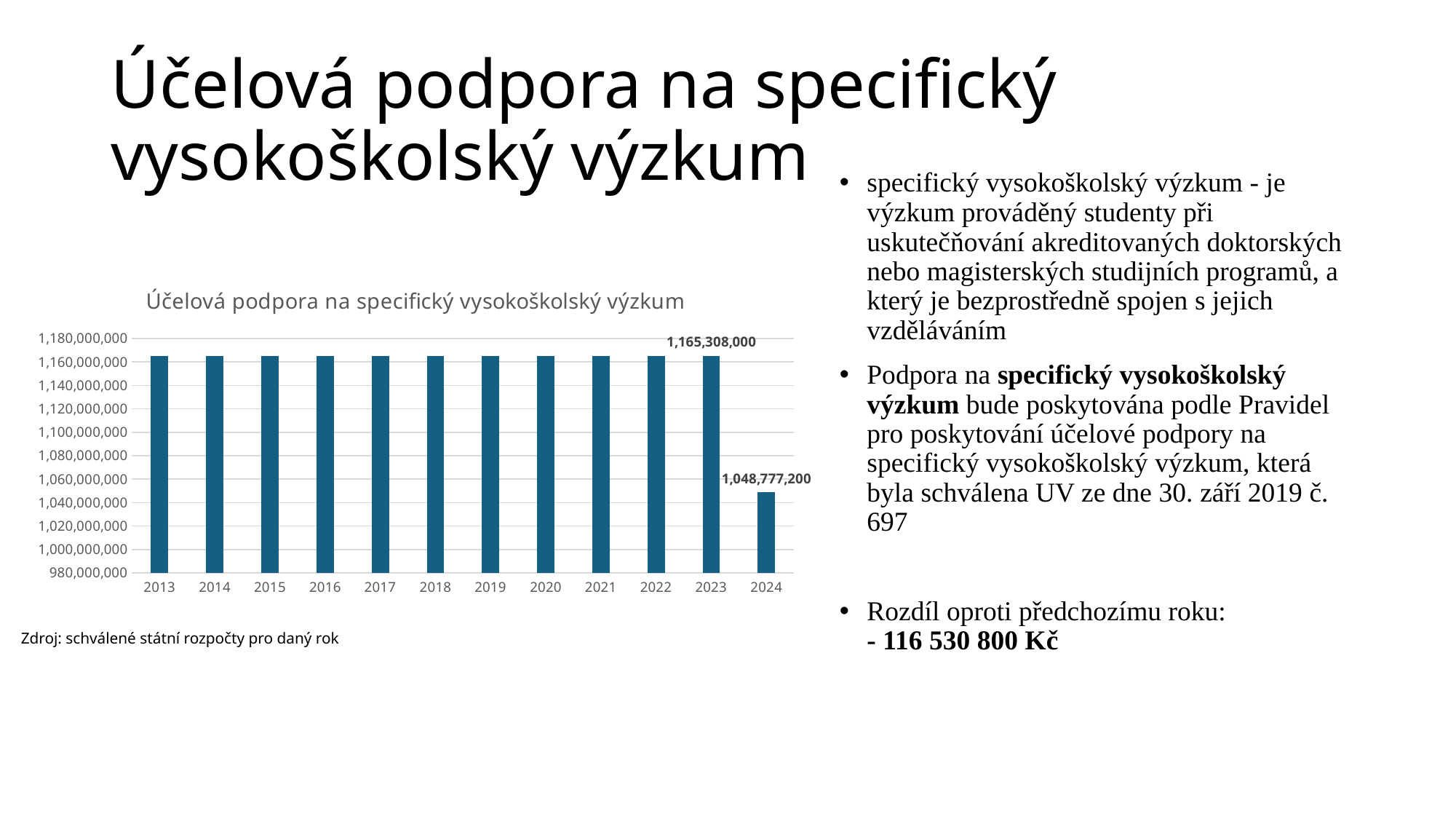
Which year has the lowest value? 2024 What is the title of the chart? Účelová podpora na specifický vysokoškolský výzkum What is the value for 2024? 1,048,777,200 What is the value for 2023? 1,165,308,000 What is the difference between the values for 2023 and 2024? 116,530,800 What is the first year shown on the x axis? 2013 Is the value for 2024 greater or less than 1,060,000,000? less What type of chart is shown on the slide? bar chart How many years are shown on the x axis? 12 Is the value for 2013 greater or less than 1,100,000,000? greater Does the value rise or fall from 2023 to 2024? fall Which is larger, the value for 2023 or the value for 2024? 2023